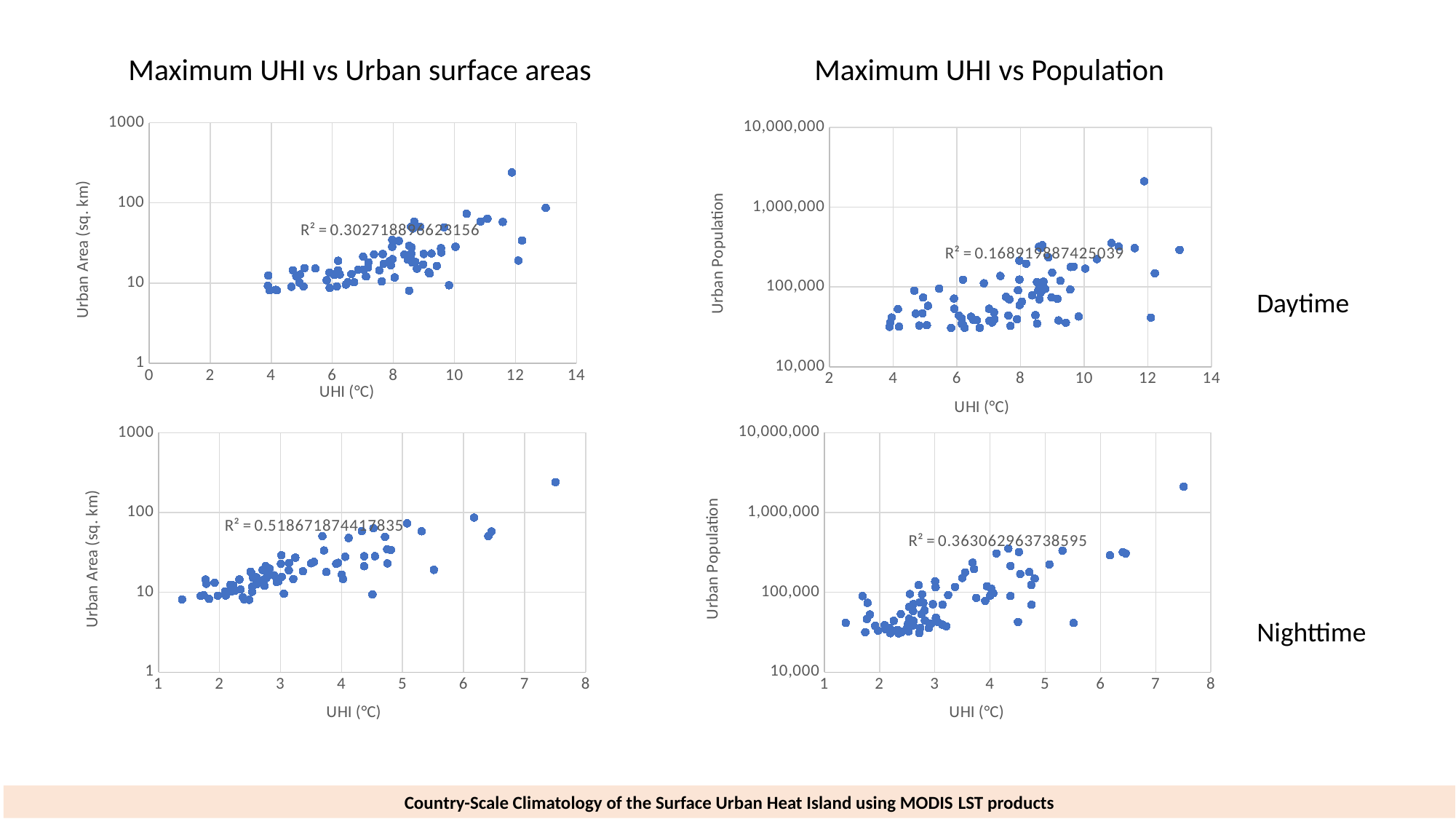
What is the label of the x-axis on the bottom-right chart (Nighttime, Maximum UHI vs Population)? UHI (°C) In the bottom-right chart (Nighttime, Maximum UHI vs Population), what R² value is printed? R² = 0.363062963738595 How many charts are shown on the slide? 4 In the bottom-left chart (Nighttime, Maximum UHI vs Urban surface areas), do urban area values generally rise or fall as UHI increases? rise In the bottom-right chart (Nighttime, Maximum UHI vs Population), is the population of the point at UHI around 7.5 °C greater or less than 1,000,000? greater What kind of chart is the top-left chart under 'Maximum UHI vs Urban surface areas'? scatter chart In the bottom-left chart (Nighttime, Maximum UHI vs Urban surface areas), is the urban area of the point at the highest UHI (around 7.5 °C) greater or less than 100? greater In the bottom-left chart (Nighttime, Maximum UHI vs Urban surface areas), what R² value is printed? R² = 0.518671874417835 In the top-right chart (Daytime, Maximum UHI vs Population), is the population of the highest point greater or less than 1,000,000? greater Which chart has the higher printed R² value: the Nighttime Maximum UHI vs Urban surface areas chart or the Nighttime Maximum UHI vs Population chart? Nighttime Maximum UHI vs Urban surface areas What is the maximum value shown on the x-axis of the top-left chart (Daytime, Maximum UHI vs Urban surface areas)? 14 What is the label of the y-axis on the top-left chart (Daytime, Maximum UHI vs Urban surface areas)? Urban Area (sq. km)